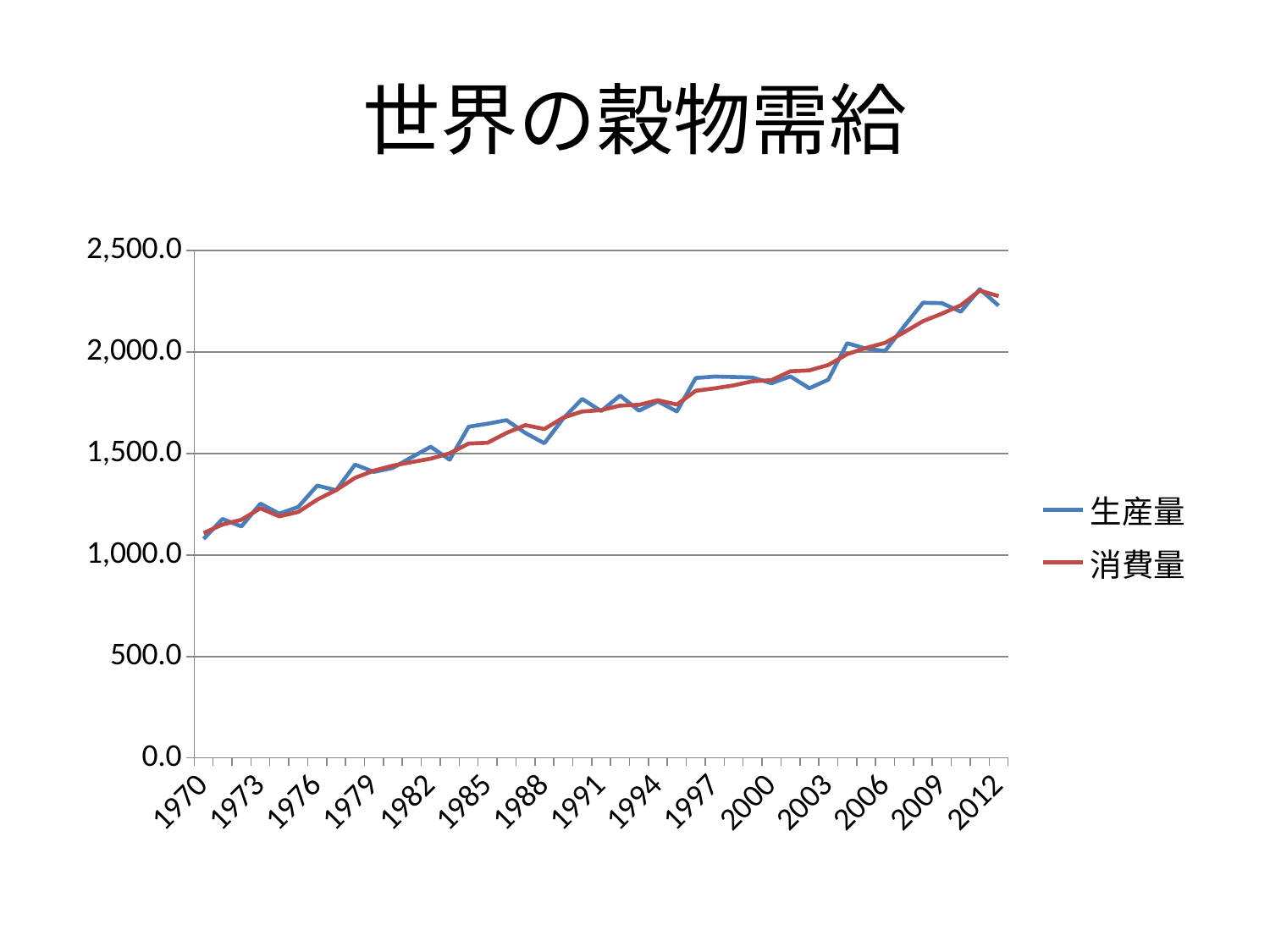
Is the value for 生産量 in 1979 greater or less than 1,500.0? less What is the title of the chart? 世界の穀物需給 How many series does the legend list? 2 Do the values for 消費量 rise or fall from 1970 to 2012? rise Is the value for 生産量 in 1970 greater or less than 1,000.0? greater Is the value for 消費量 in 2000 greater or less than 2,000.0? less In 2003, which is larger, 生産量 or 消費量? 消費量 Which series is drawn in red? 消費量 Do the values for 生産量 rise or fall from 1970 to 2012? rise What kind of chart is shown on the slide? line chart In which year is the value for 生産量 lowest? 1970